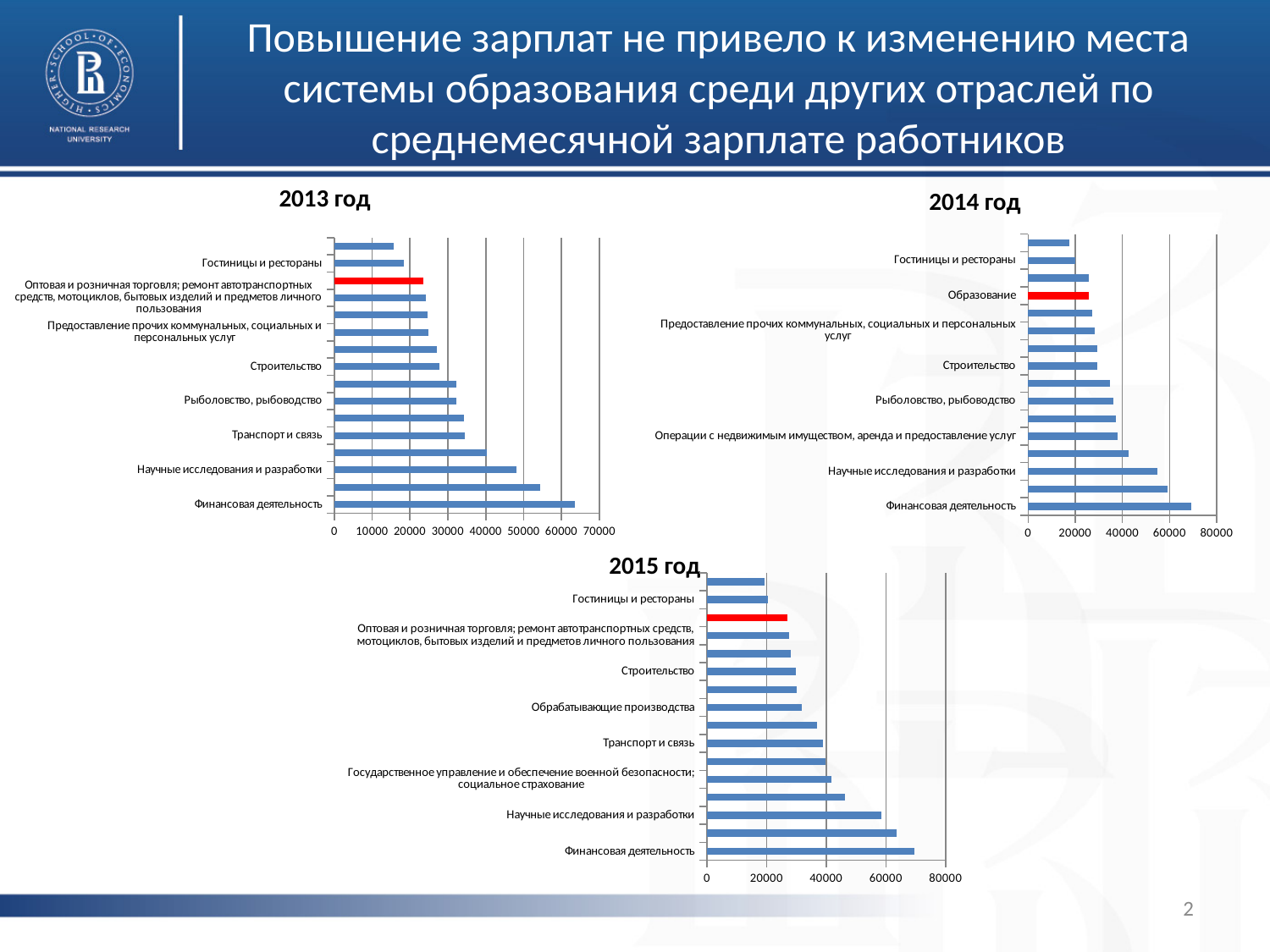
In the '2014 год' chart, which labelled category has the highest value? Финансовая деятельность In the '2015 год' chart, is the value for Финансовая деятельность greater or less than 60000? greater In the '2013 год' chart, is the value for Гостиницы и рестораны greater or less than 30000? less In the '2013 год' chart, which is larger: the value for Финансовая деятельность or the value for Строительство? Финансовая деятельность In the '2013 год' chart, is the value for Финансовая деятельность greater or less than 60000? greater In the '2014 год' chart, which category is highlighted with a red bar? Образование How many charts are shown on the slide? 3 In the '2013 год' chart, which labelled category has the highest value? Финансовая деятельность What kind of chart is the '2013 год' chart? bar chart In the '2014 год' chart, which is larger: the value for Образование or the value for Научные исследования и разработки? Научные исследования и разработки In the '2015 год' chart, which labelled category has the highest value? Финансовая деятельность